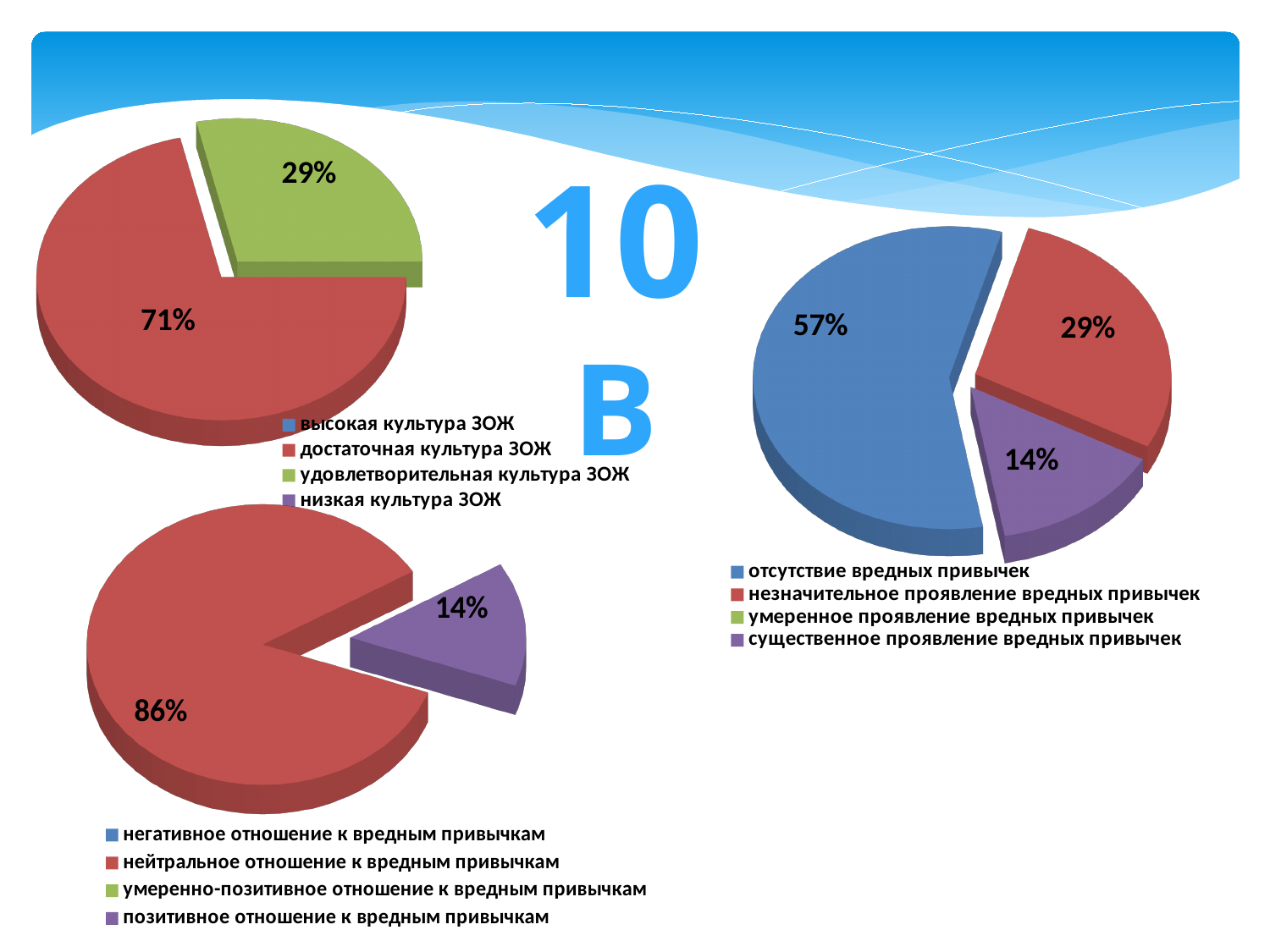
In the right-hand pie chart, which is larger: 'незначительное проявление вредных привычек' or 'существенное проявление вредных привычек'? незначительное проявление вредных привычек How many entries does the legend of the right-hand pie chart list? 4 What type of chart is the bottom-left chart? pie chart In the bottom-left pie chart, what share is labelled for 'позитивное отношение к вредным привычкам'? 14% In the right-hand pie chart, what share is labelled for 'отсутствие вредных привычек'? 57% In the top-left pie chart, what is the difference between the 71% slice and the 29% slice? 42% In the top-left pie chart, which category has the largest slice? достаточная культура ЗОЖ In the right-hand pie chart, what share is labelled for 'существенное проявление вредных привычек'? 14% In the bottom-left pie chart, what share is labelled for 'нейтральное отношение к вредным привычкам'? 86% In the bottom-left pie chart, which category has the smallest slice? позитивное отношение к вредным привычкам In the top-left pie chart, what share is labelled for 'удовлетворительная культура ЗОЖ'? 29% In the top-left pie chart, what share is labelled for 'достаточная культура ЗОЖ'? 71%